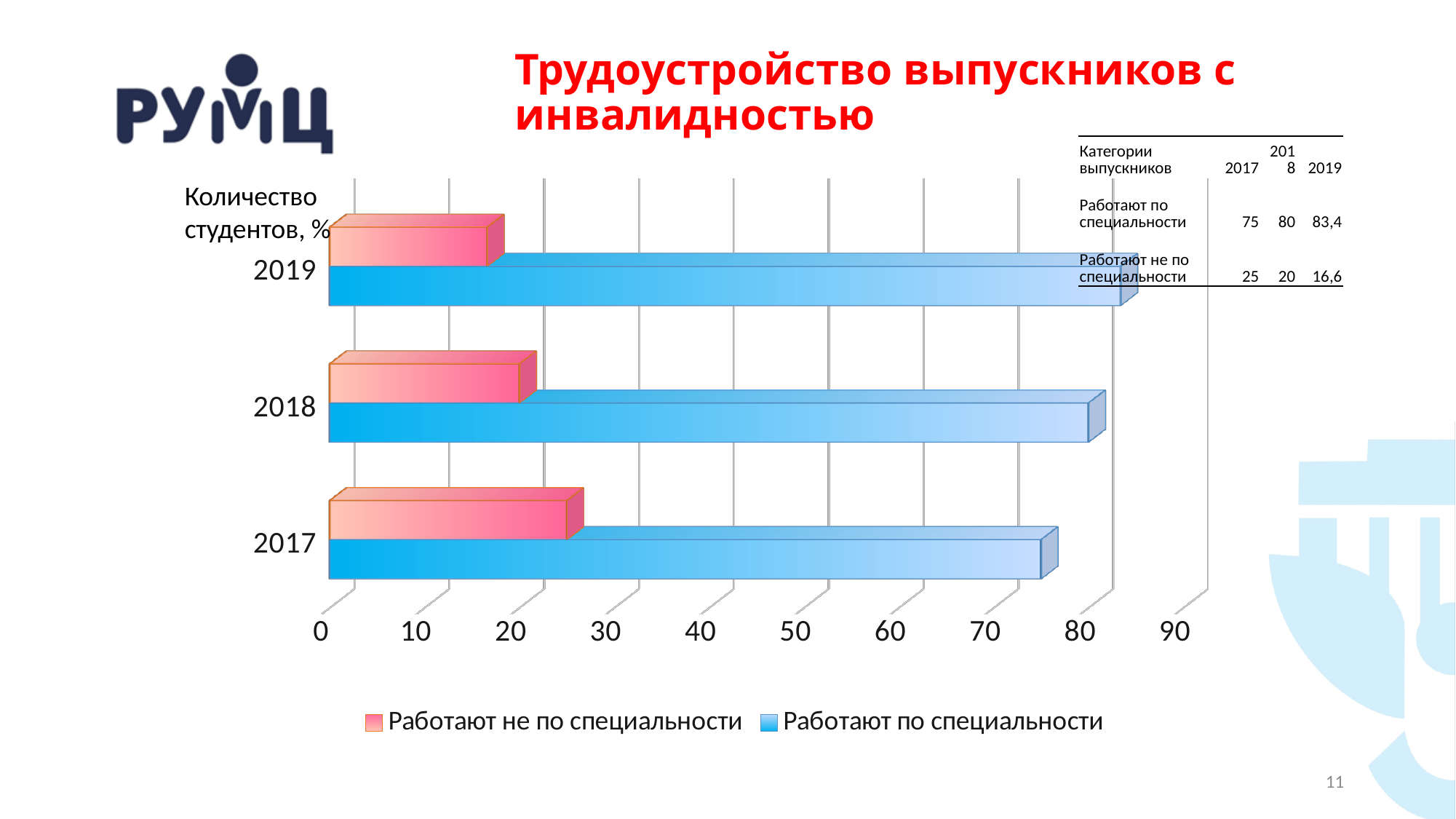
According to the table on the slide, what is the value for "Работают по специальности" in 2019? 83,4 According to the table on the slide, what is the value for "Работают не по специальности" in 2017? 25 What kind of chart is shown on the slide? bar chart How many series does the chart legend list? 2 According to the table on the slide, what is the value for "Работают по специальности" in 2018? 80 Which year has the highest value for "Работают по специальности"? 2019 How many years (categories) are shown on the chart? 3 Does the value for "Работают по специальности" rise or fall from 2017 to 2019? rise Which year has the lowest value for "Работают не по специальности"? 2019 What is the difference between "Работают по специальности" and "Работают не по специальности" in 2017? 50 Is the value for "Работают по специальности" in 2017 greater or less than 70? greater Which colour represents the series "Работают не по специальности" in the legend? pink